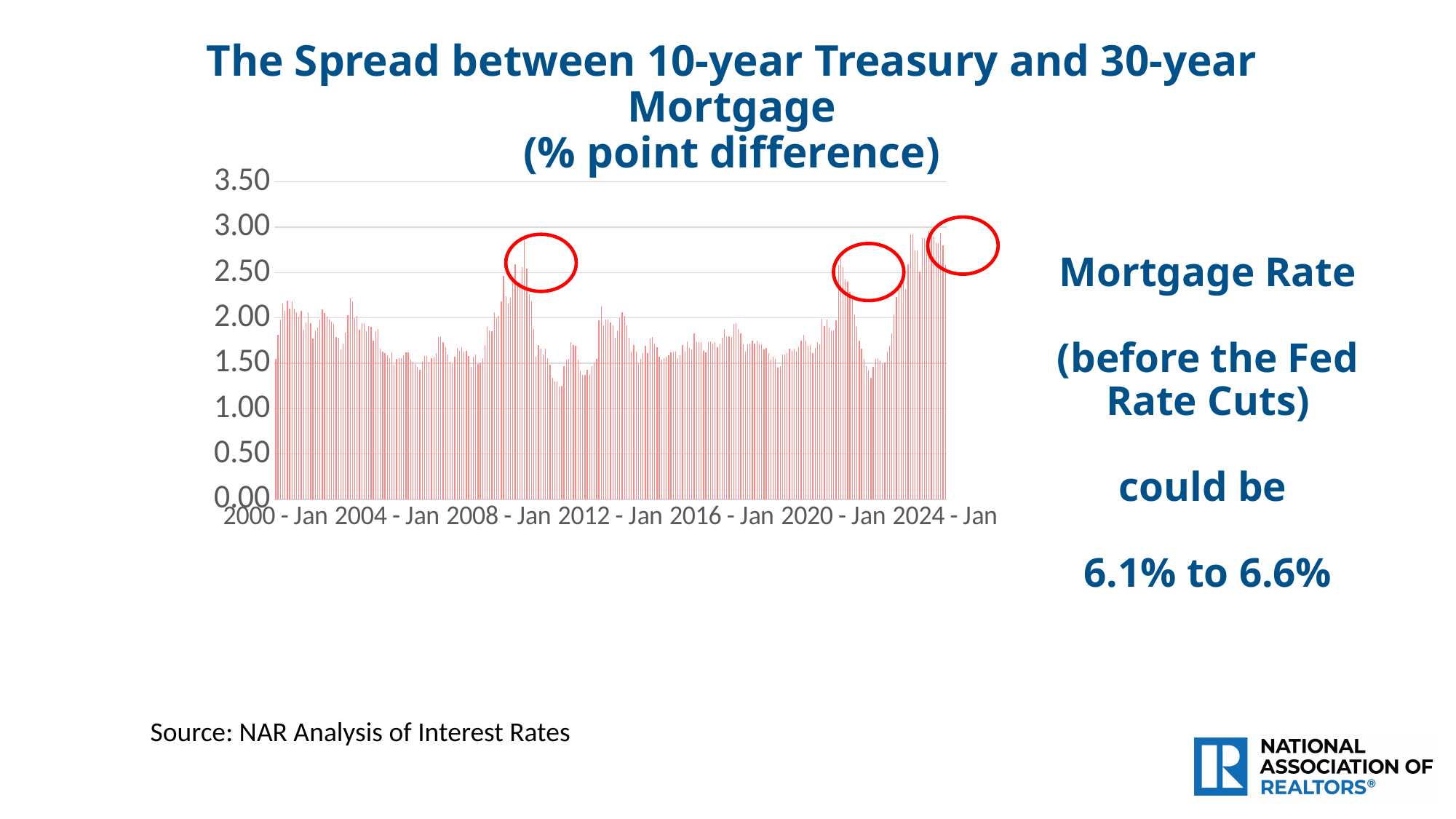
How many labels are shown along the chart's horizontal axis? 7 Is the lowest spread value shown on the chart greater or less than 1.50? less Is the spread value at 2016 - Jan greater or less than 2.50? less What is the highest value labelled on the chart's vertical axis? 3.50 What is the title of the chart? The Spread between 10-year Treasury and 30-year Mortgage (% point difference) What kind of chart is shown on the slide? bar chart Is the spread value at 2024 - Jan greater or less than 2.00? greater What source is cited for the chart? NAR Analysis of Interest Rates What is the first label on the chart's horizontal axis? 2000 - Jan What is the last label on the chart's horizontal axis? 2024 - Jan